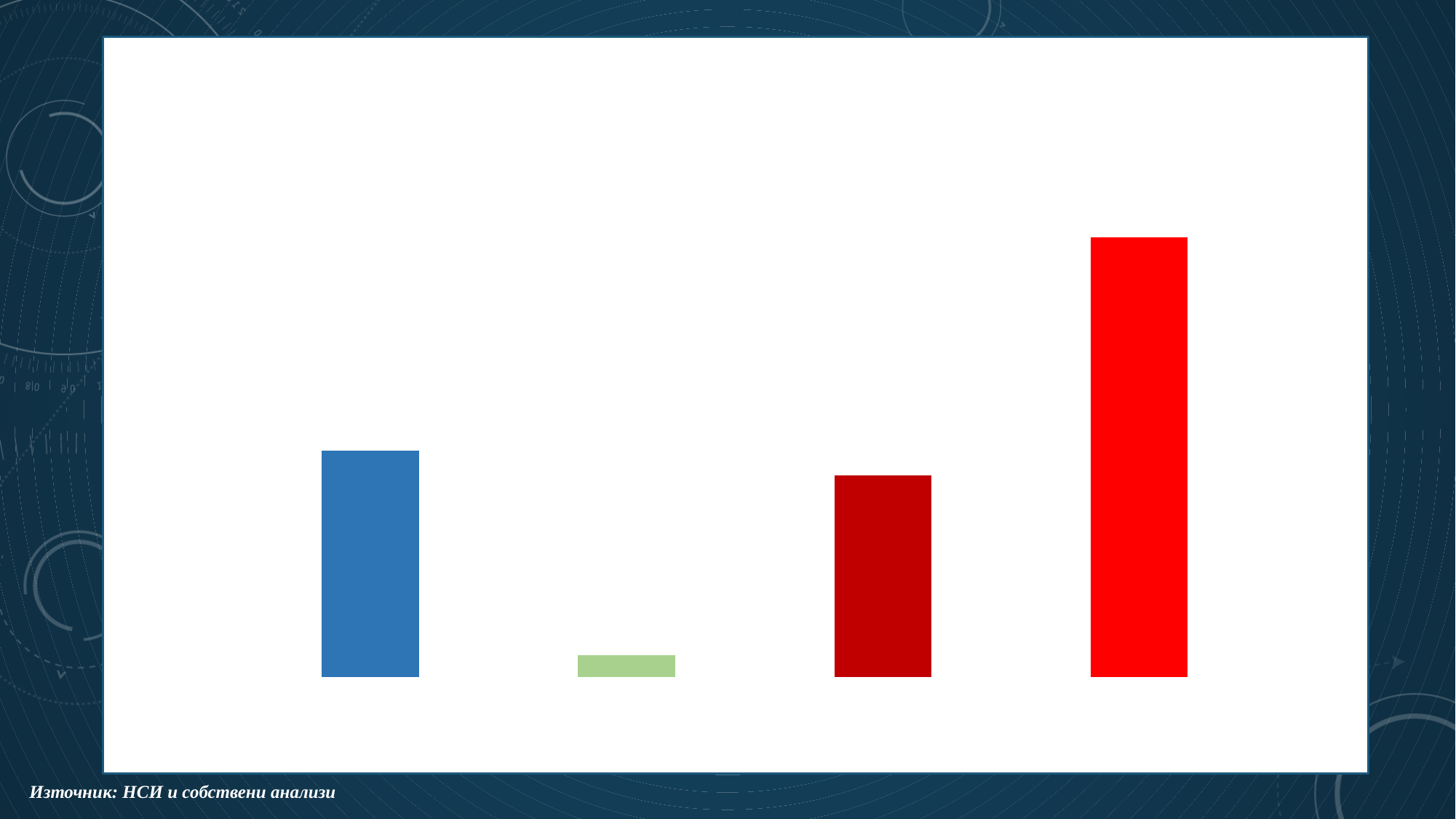
Which is taller, the first (blue) bar or the third (dark red) bar? the first (blue) bar Which bar is the shortest in the chart: the first (blue), second (green), third (dark red) or fourth (bright red)? the second (green) What colour is the tallest bar in the chart? bright red How many bars are plotted in the chart? 4 What kind of chart is shown on the slide? bar chart Which bar is the tallest in the chart: the first (blue), second (green), third (dark red) or fourth (bright red)? the fourth (bright red) Which is taller, the second (green) bar or the fourth (bright red) bar? the fourth (bright red) bar Which is taller, the first (blue) bar or the second (green) bar? the first (blue) bar What source is cited below the chart? НСИ и собствени анализи